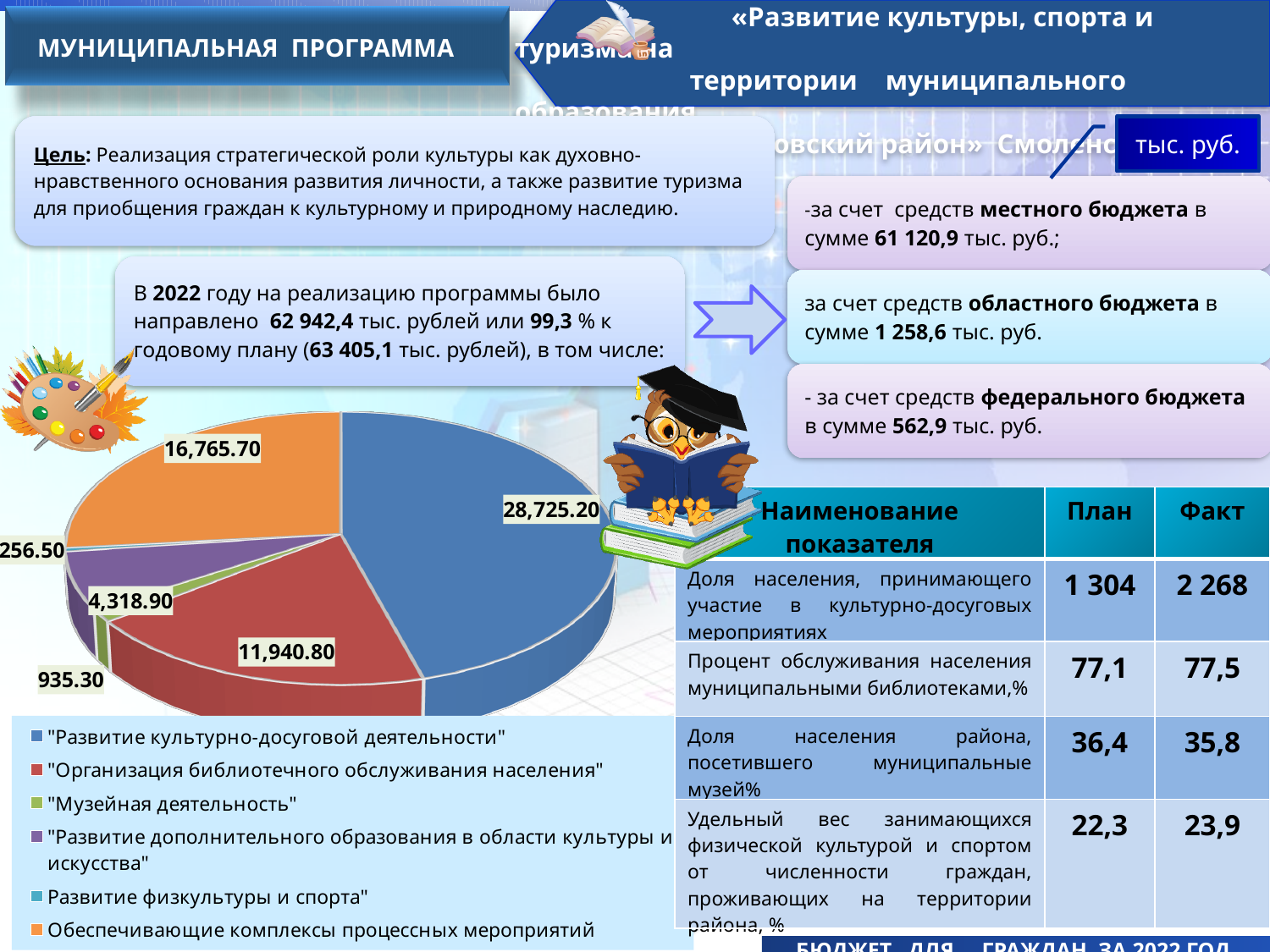
What kind of chart is shown on the slide? pie chart Which category has the largest slice in the pie chart? "Развитие культурно-досуговой деятельности" What is the difference between the values for "Развитие культурно-досуговой деятельности" and "Организация библиотечного обслуживания населения"? 16,784.40 What is the value for "Развитие дополнительного образования в области культуры и искусства" in the pie chart? 4,318.90 What is the value for "Музейная деятельность" in the pie chart? 935.30 How many slices does the pie chart have? 6 Which is larger in the pie chart: "Обеспечивающие комплексы процессных мероприятий" or "Организация библиотечного обслуживания населения"? "Обеспечивающие комплексы процессных мероприятий" What is the value for "Развитие культурно-досуговой деятельности" in the pie chart? 28,725.20 What colour is the slice for "Музейная деятельность" in the pie chart? green What is the value for "Обеспечивающие комплексы процессных мероприятий" in the pie chart? 16,765.70 Which category has the smallest slice in the pie chart? Развитие физкультуры и спорта" What is the value for "Организация библиотечного обслуживания населения" in the pie chart? 11,940.80